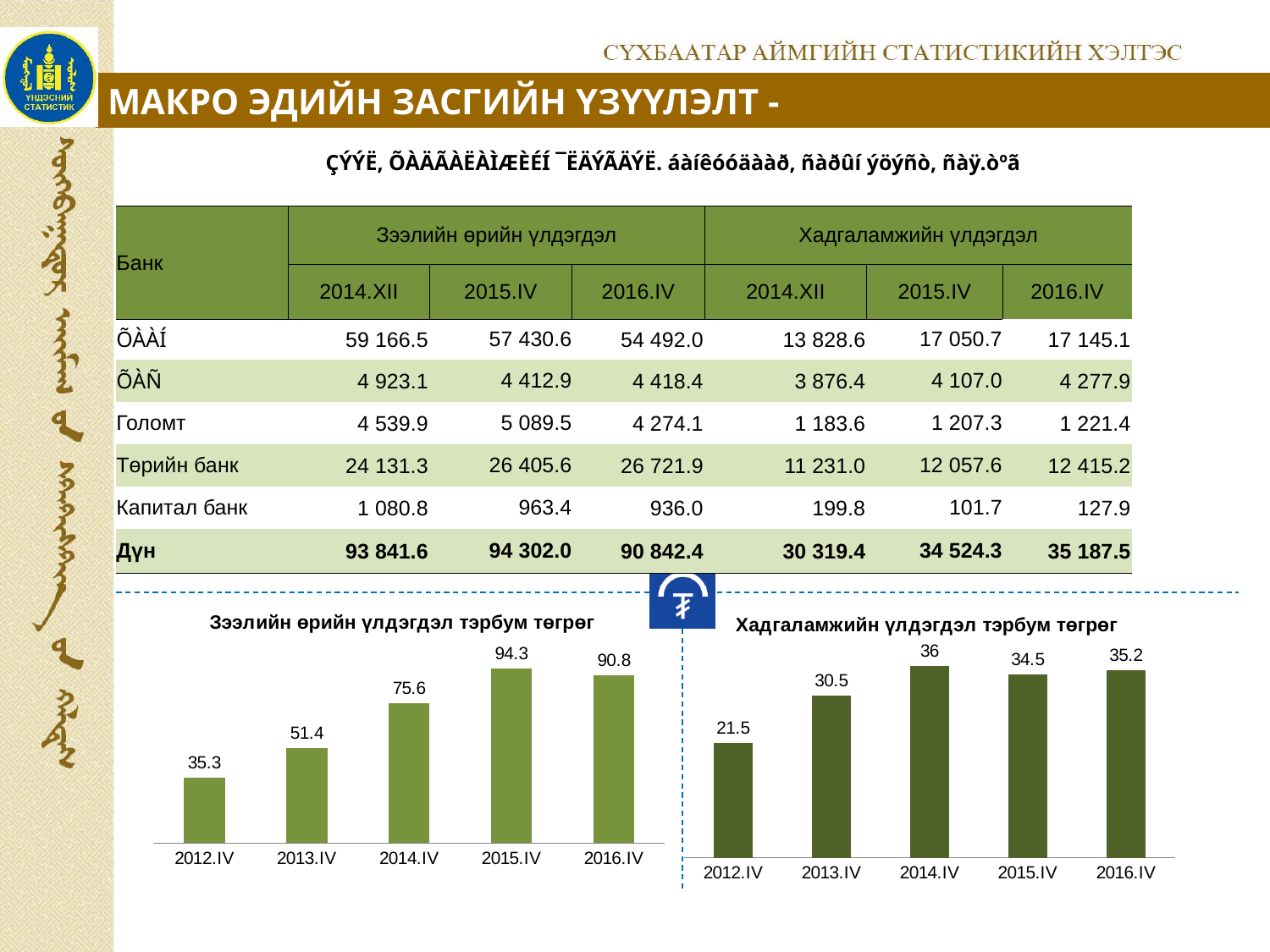
In the chart titled 'Зээлийн өрийн үлдэгдэл тэрбум төгрөг', which is larger, the value for 2013.IV or the value for 2014.IV? 2014.IV In the chart titled 'Хадгаламжийн үлдэгдэл тэрбум төгрөг', what is the value for 2016.IV? 35.2 In the chart titled 'Зээлийн өрийн үлдэгдэл тэрбум төгрөг', what is the value for 2014.IV? 75.6 In the chart titled 'Хадгаламжийн үлдэгдэл тэрбум төгрөг', what is the value for 2013.IV? 30.5 In the chart titled 'Хадгаламжийн үлдэгдэл тэрбум төгрөг', what is the difference between the values for 2014.IV and 2012.IV? 14.5 In the chart titled 'Зээлийн өрийн үлдэгдэл тэрбум төгрөг', do the values rise or fall from 2012.IV to 2015.IV? Rise In the chart titled 'Хадгаламжийн үлдэгдэл тэрбум төгрөг', which is larger, the value for 2012.IV or the value for 2013.IV? 2013.IV How many bars are shown in the chart titled 'Зээлийн өрийн үлдэгдэл тэрбум төгрөг'? 5 In the chart titled 'Хадгаламжийн үлдэгдэл тэрбум төгрөг', which period has the lowest value? 2012.IV In the chart titled 'Зээлийн өрийн үлдэгдэл тэрбум төгрөг', what is the difference between the values for 2015.IV and 2016.IV? 3.5 What type of chart is the chart titled 'Хадгаламжийн үлдэгдэл тэрбум төгрөг'? Bar chart In the chart titled 'Зээлийн өрийн үлдэгдэл тэрбум төгрөг', which period has the highest value? 2015.IV